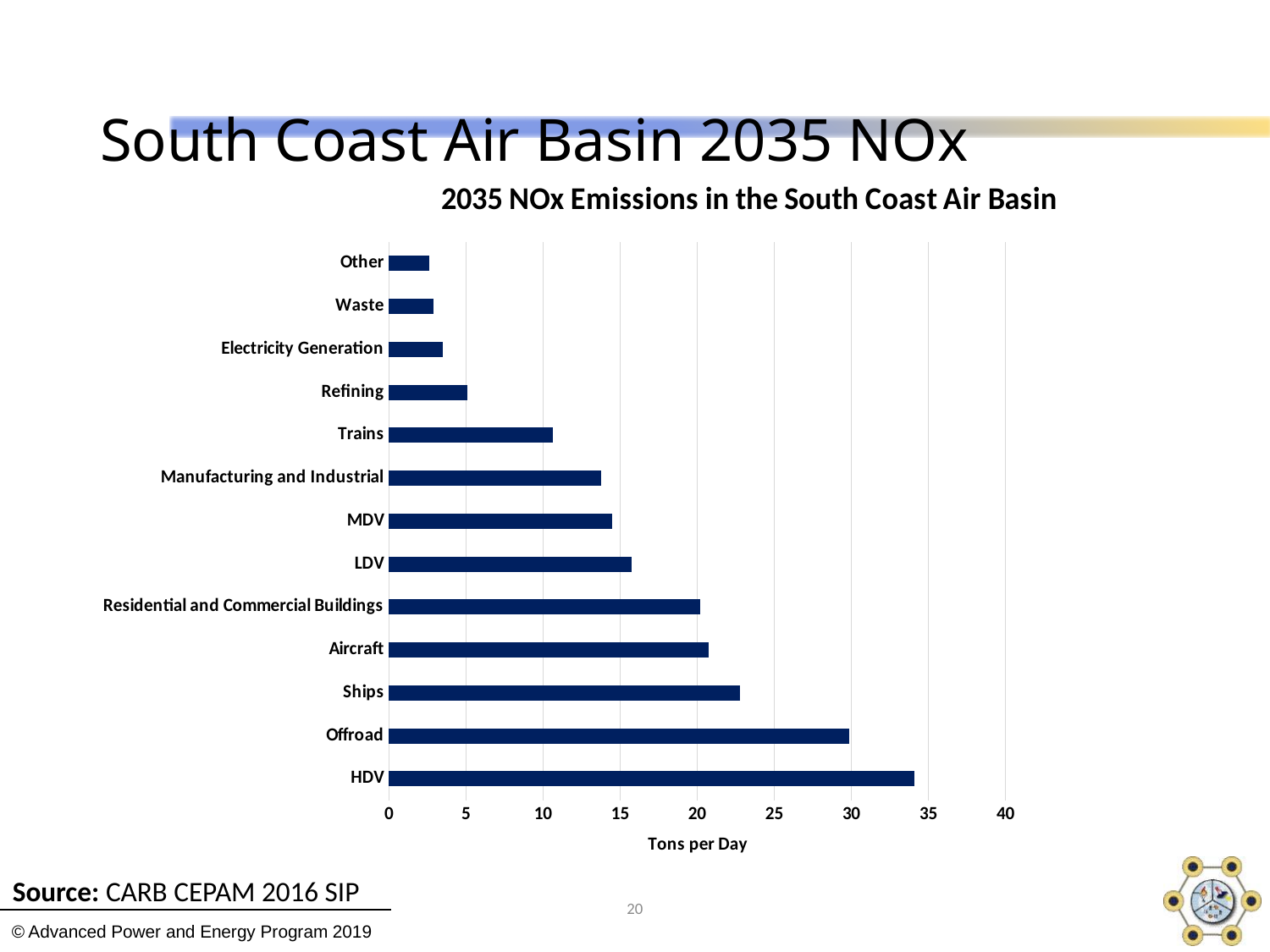
What kind of chart is shown on the slide? bar chart Is the value for Electricity Generation greater or less than 5? less What is the title of the chart? 2035 NOx Emissions in the South Coast Air Basin Which category has the highest NOx emissions? HDV Is the value for HDV greater or less than 30? greater Is the value for Trains greater or less than 15? less Which has higher NOx emissions, Trains or Refining? Trains Which has higher NOx emissions, HDV or Offroad? HDV What is the label of the horizontal axis? Tons per Day How many source categories are plotted in the chart? 13